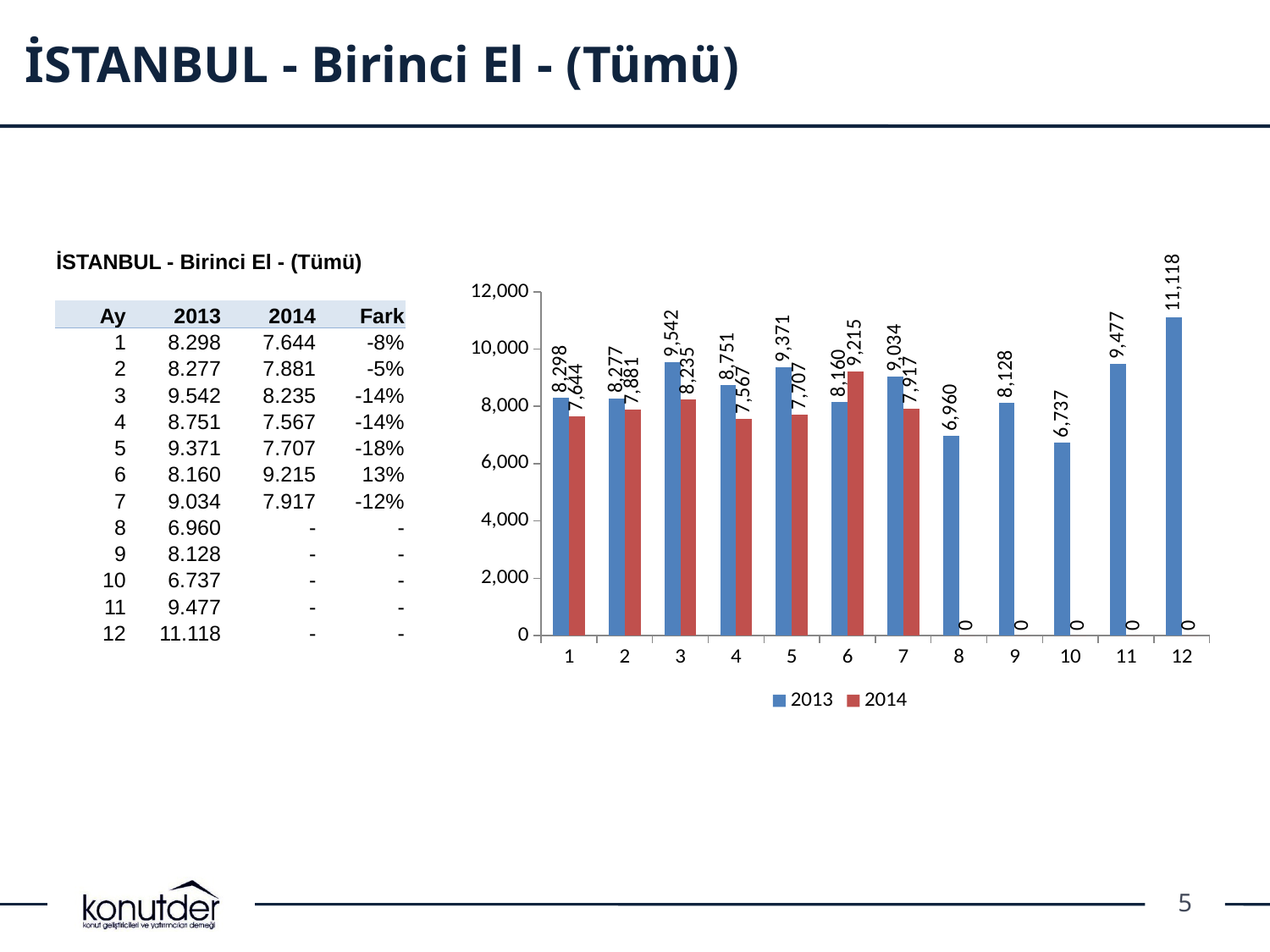
What is the 2014 value for category 6? 9,215 Which category has the lowest 2013 value? 10 Which category has the highest 2014 value among categories 1 to 7? 6 What is the 2013 value for category 12? 11,118 What type of chart is shown on the slide? bar chart How many categories are shown on the x axis? 12 How many series does the chart legend list? 2 Which category has the highest 2013 value? 12 What is the 2013 value for category 10? 6,737 Which series is shown in red in the chart? 2014 What is the difference between the 2013 and 2014 values for category 5? 1,664 Which is larger for category 6, the 2013 value or the 2014 value? 2014